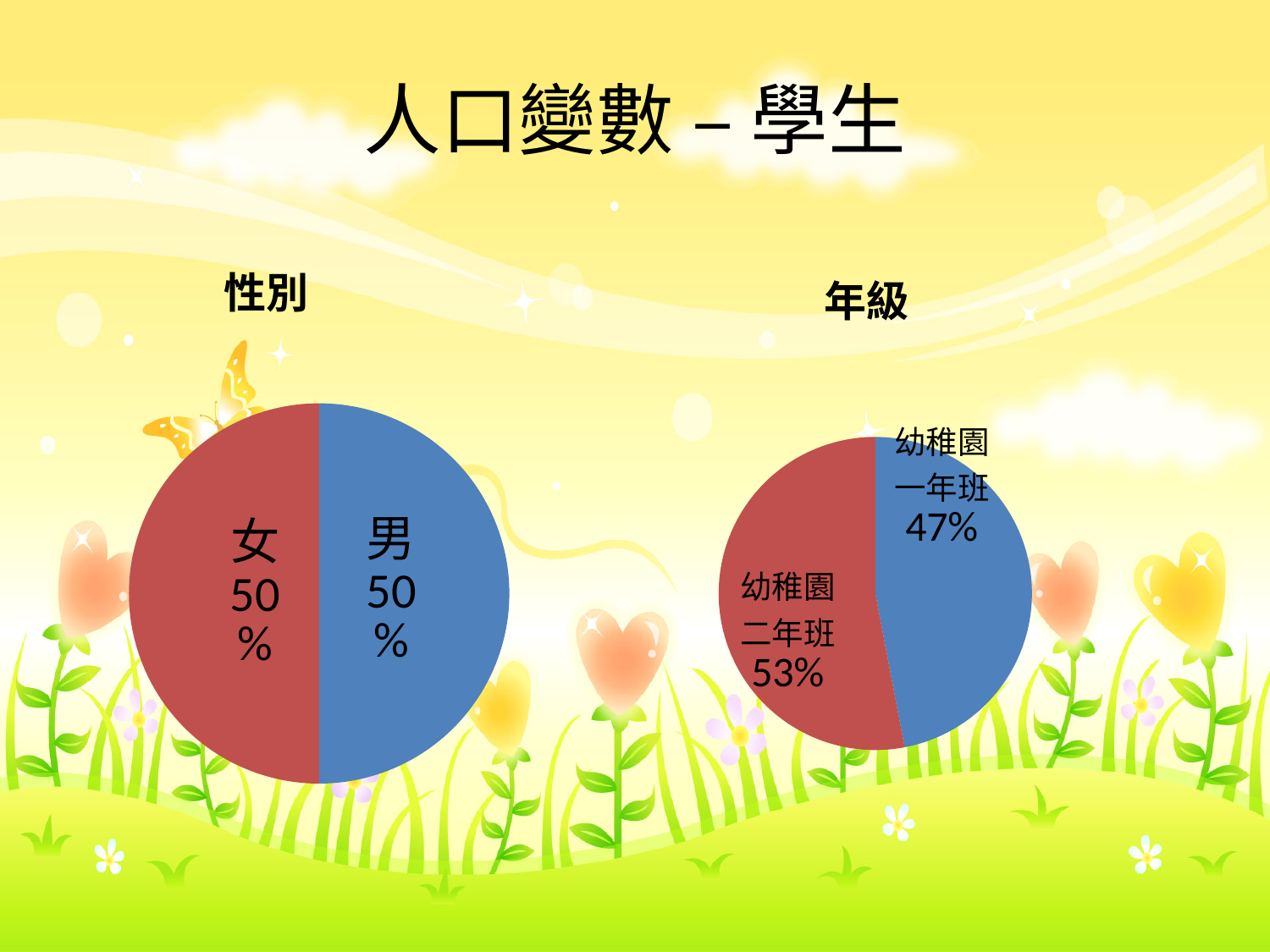
In the 年級 chart, what is the difference in percentage points between 幼稚園二年班 and 幼稚園一年班? 6 In the 年級 chart, which is larger, 幼稚園一年班 or 幼稚園二年班? 幼稚園二年班 In the 年級 chart, which category has the smallest slice? 幼稚園一年班 What kind of chart is the 性別 chart? Pie chart In the 年級 chart, which category has the largest slice? 幼稚園二年班 In the 性別 chart, what share is labelled for 男? 50% In the 年級 chart, what share is labelled for 幼稚園一年班? 47% How many slices does the 年級 chart have? 2 How many slices does the 性別 chart have? 2 In the 性別 chart, what share is labelled for 女? 50% In the 年級 chart, what share is labelled for 幼稚園二年班? 53% In the 性別 chart, what colour is the 男 slice? Blue